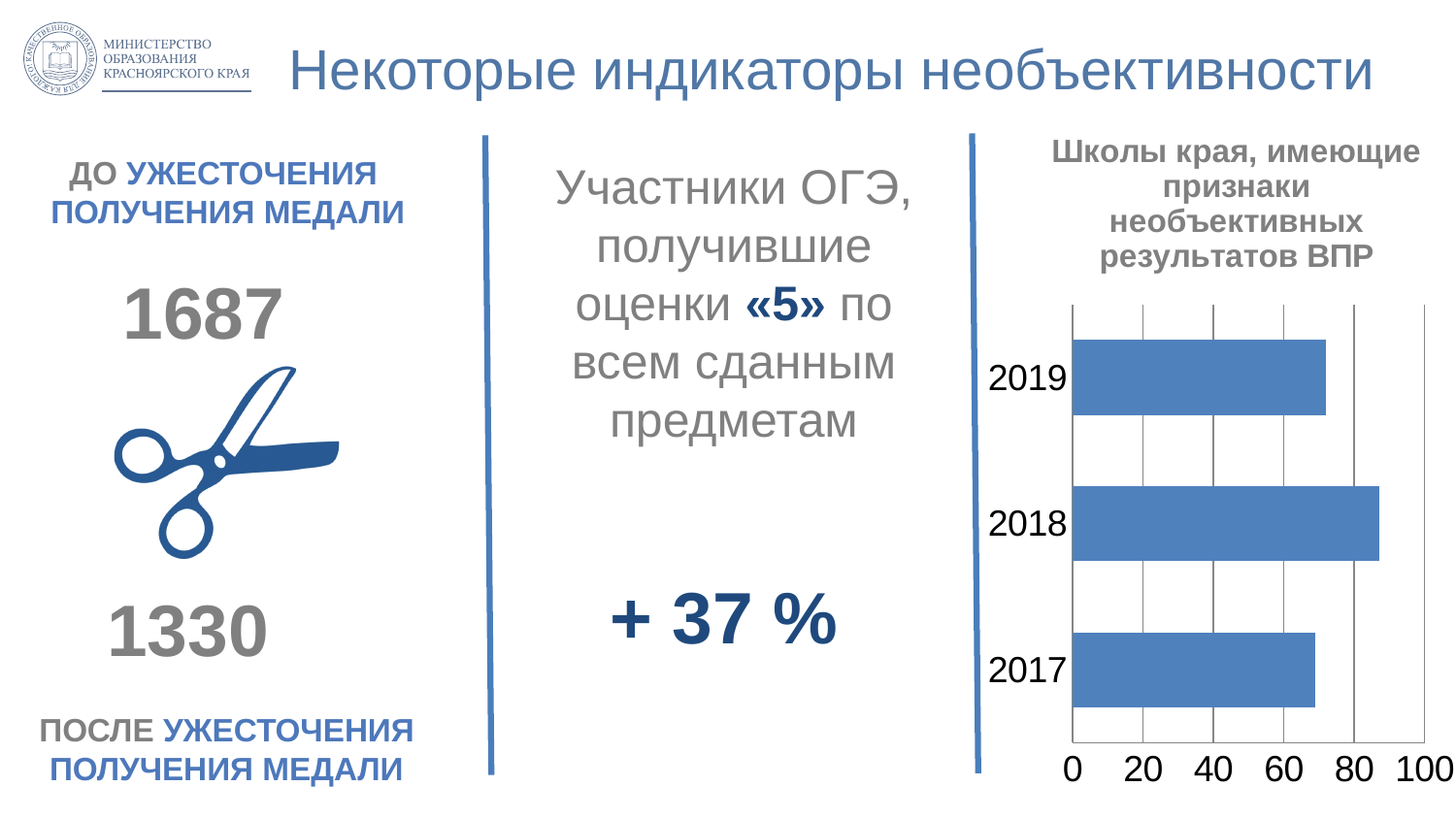
How many years (categories) are plotted in the chart? 3 Which is larger in the chart, the value for 2018 or the value for 2019? 2018 What is the title of the chart on the right side of the slide? Школы края, имеющие признаки необъективных результатов ВПР Which is larger in the chart, the value for 2018 or the value for 2017? 2018 Is the value for 2019 greater or less than 80? less Is the value for 2018 greater or less than 80? greater Is the value for 2017 greater or less than 60? greater What is the maximum value shown on the horizontal axis of the chart? 100 Which year has the highest value in the chart? 2018 What kind of chart is shown on the right side of the slide? bar chart